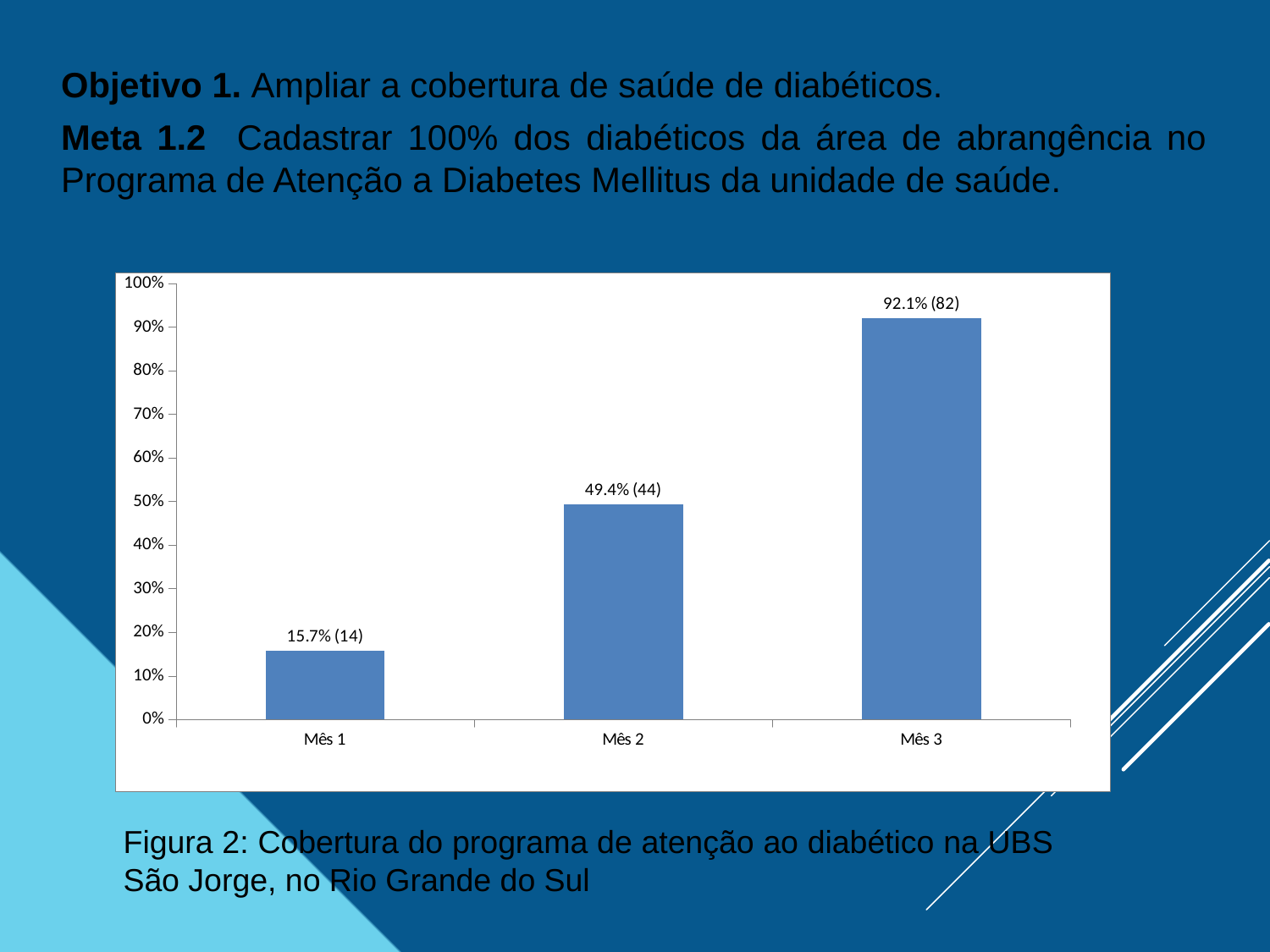
What is the value shown for Mês 1? 15.7% (14) What is the value shown for Mês 2? 49.4% (44) What is the value shown for Mês 3? 92.1% (82) Do the values rise or fall from Mês 1 to Mês 3? rise Which month has the highest coverage? Mês 3 Which is larger, the value for Mês 1 or the value for Mês 2? Mês 2 How many more people were registered in Mês 3 than in Mês 1? 68 Is the value for Mês 2 greater or less than 60%? less What is the difference in percentage points between Mês 3 and Mês 2? 42.7 Which month has the lowest coverage? Mês 1 How many months are shown on the x axis? 3 What kind of chart is shown on the slide? bar chart